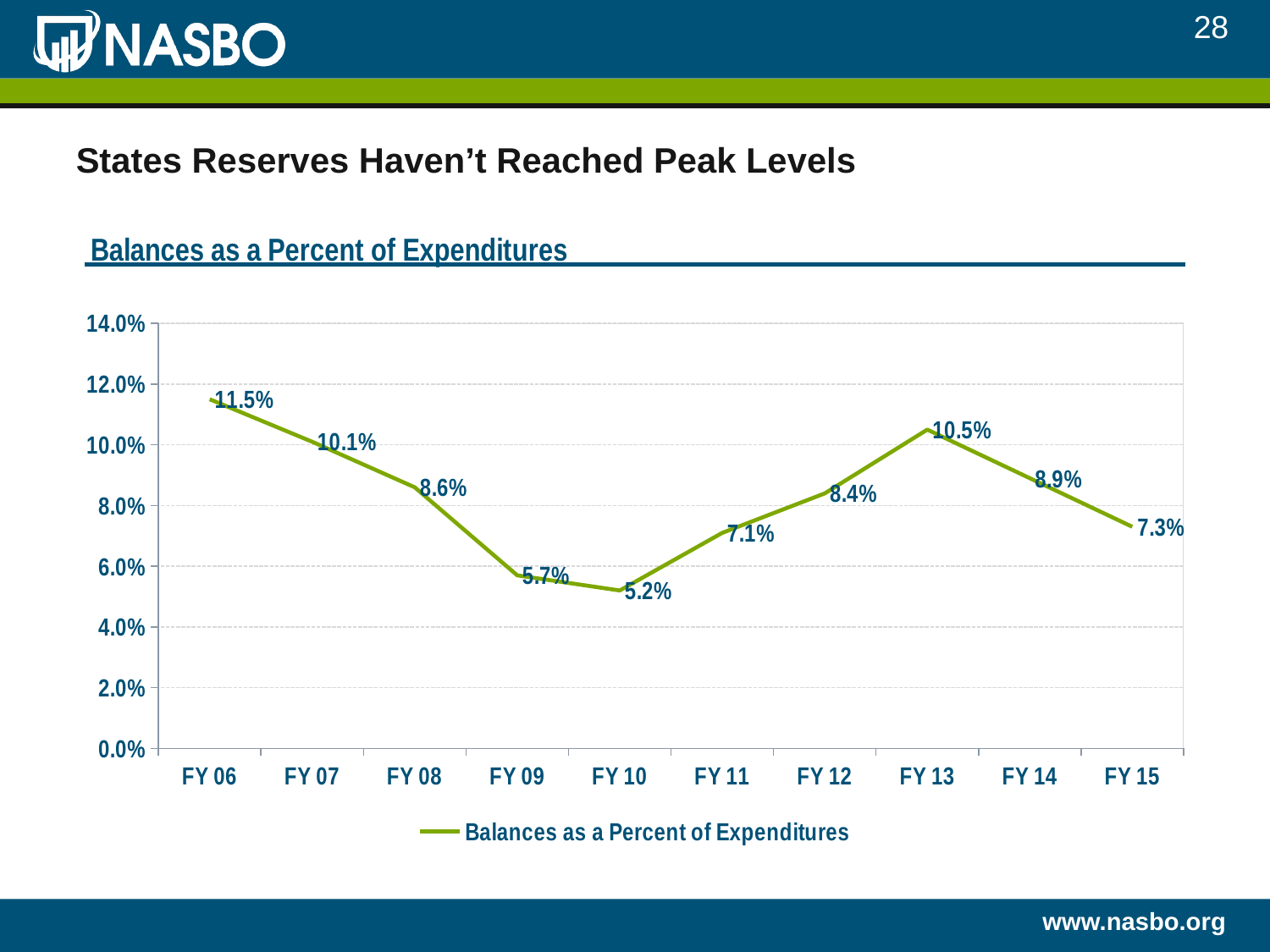
Which is larger, the value for FY 12 or the value for FY 14? FY 14 What is the value for FY 10? 5.2% What is the value for FY 15? 7.3% Do the values rise or fall from FY 10 to FY 13? Rise How many fiscal years are plotted on the chart? 10 What is the value for FY 06? 11.5% Which fiscal year has the highest value? FY 06 How many series does the legend list? 1 What is the value for FY 13? 10.5% Which fiscal year has the lowest value? FY 10 What kind of chart is shown? Line chart What is the difference between the values for FY 06 and FY 15? 4.2%